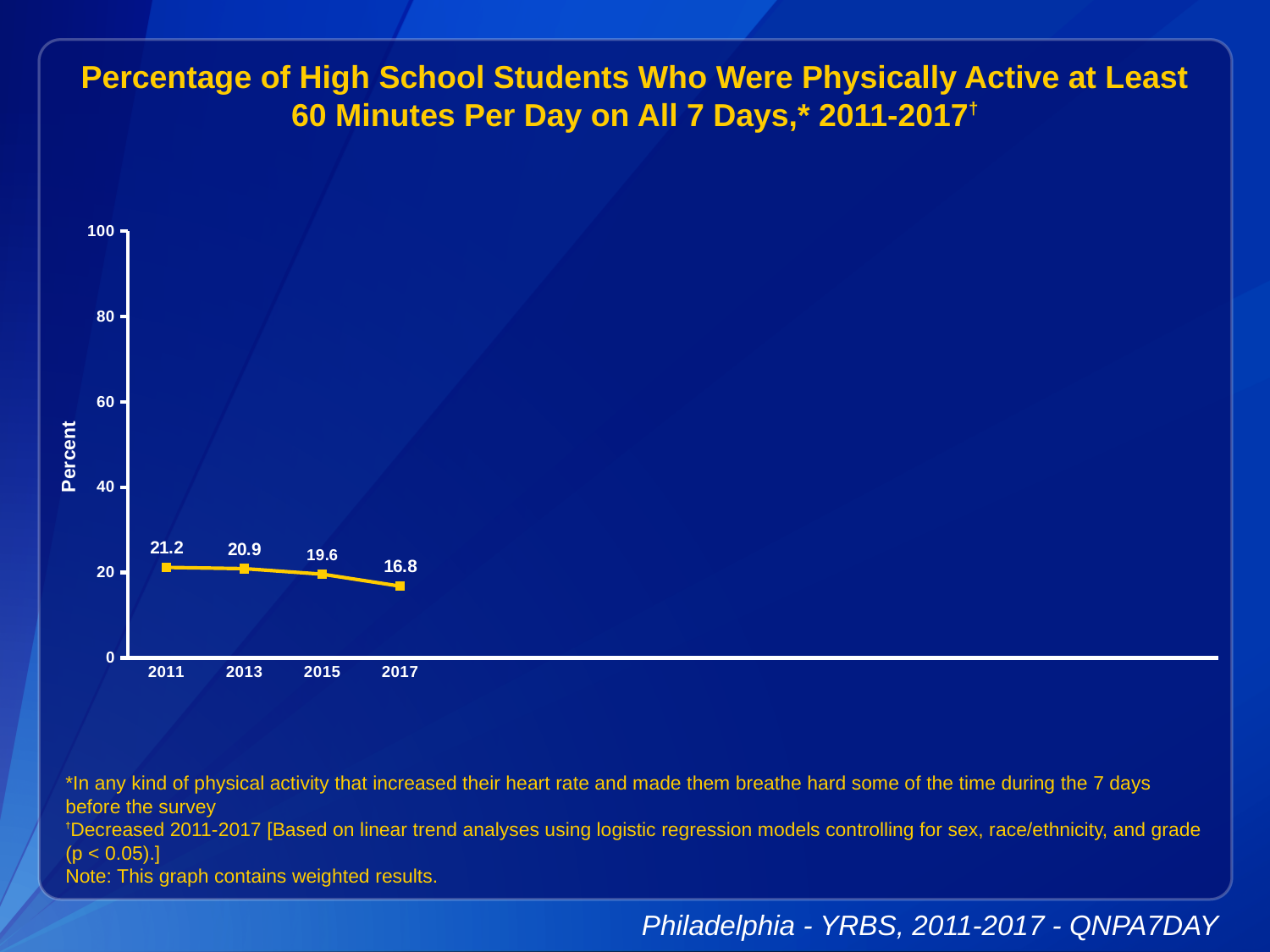
Which is larger, the value for 2013 or the value for 2015? 2013 Which year has the lowest value? 2017 Do the values rise or fall from 2011 to 2017? fall What was the percentage of high school students who were physically active at least 60 minutes per day on all 7 days in 2011? 21.2 How many years are plotted on the chart? 4 What kind of chart is shown? line chart Which year has the highest value? 2011 What value is shown for 2017? 16.8 What is the difference between the 2011 value and the 2017 value? 4.4 Is the value for 2017 greater or less than 20? less What value is shown for 2015? 19.6 What is the label on the y axis? Percent